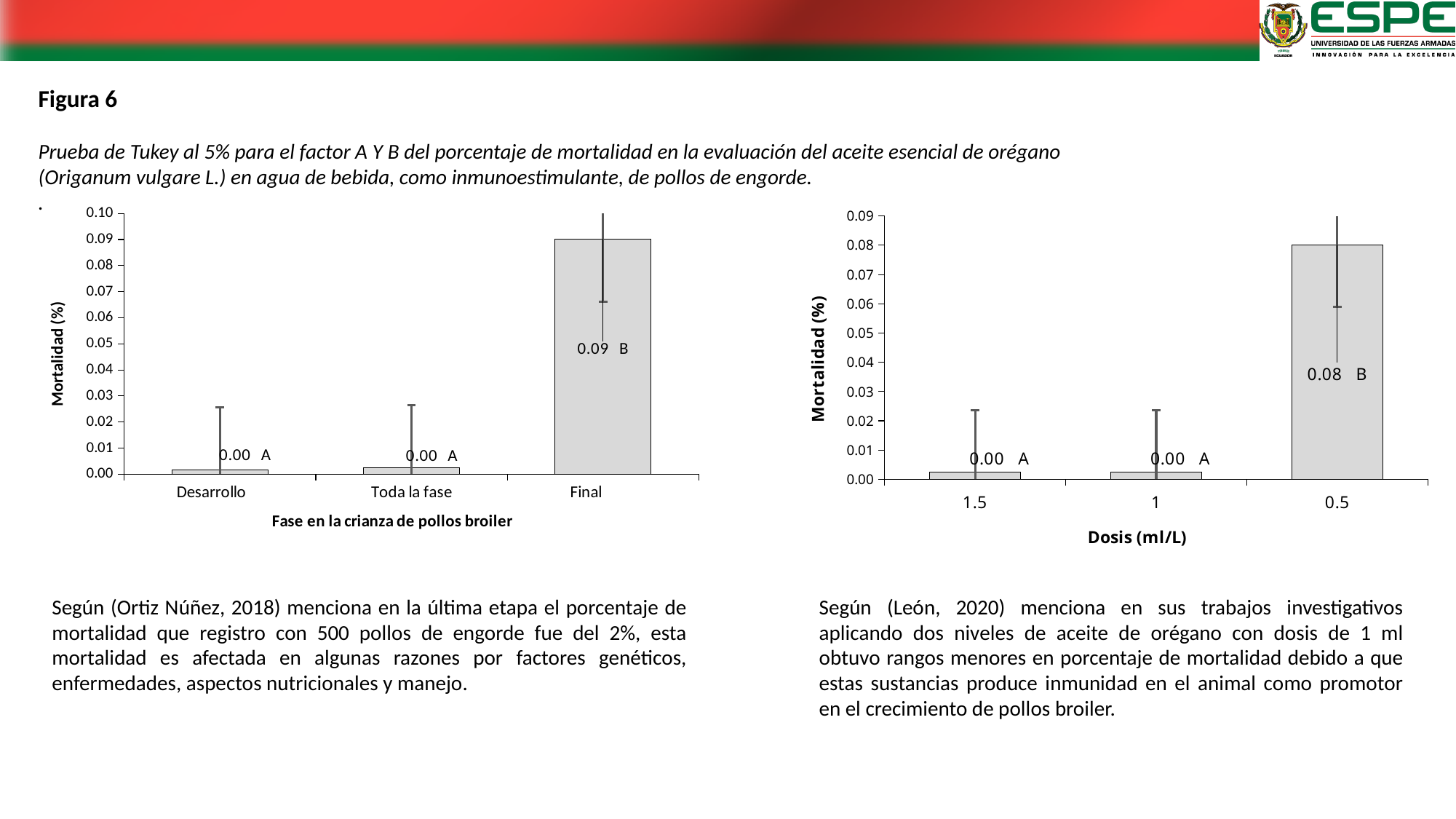
In the right chart (Dosis (ml/L)), what is the difference in mortality between the 0.5 dose and the 1 dose? 0.08 In the left chart (Fase en la crianza de pollos broiler), what is the difference in mortality between Final and Toda la fase? 0.09 In the left chart (Fase en la crianza de pollos broiler), what is the mortality value for Desarrollo? 0.00 What is the y-axis label of the left chart (Fase en la crianza de pollos broiler)? Mortalidad (%) What type of chart is the right chart (Dosis (ml/L))? Bar chart In the left chart (Fase en la crianza de pollos broiler), what is the mortality value for Final? 0.09 In the right chart (Dosis (ml/L)), which has the larger mortality value, the 0.5 dose or the 1.5 dose? 0.5 How many categories are shown on the x axis of the left chart (Fase en la crianza de pollos broiler)? 3 In the right chart (Dosis (ml/L)), which dose has the highest mortality? 0.5 In the right chart (Dosis (ml/L)), what is the mortality value for the 0.5 dose? 0.08 In the left chart (Fase en la crianza de pollos broiler), which phase has the highest mortality? Final In the right chart (Dosis (ml/L)), what is the mortality value for the 1.5 dose? 0.00